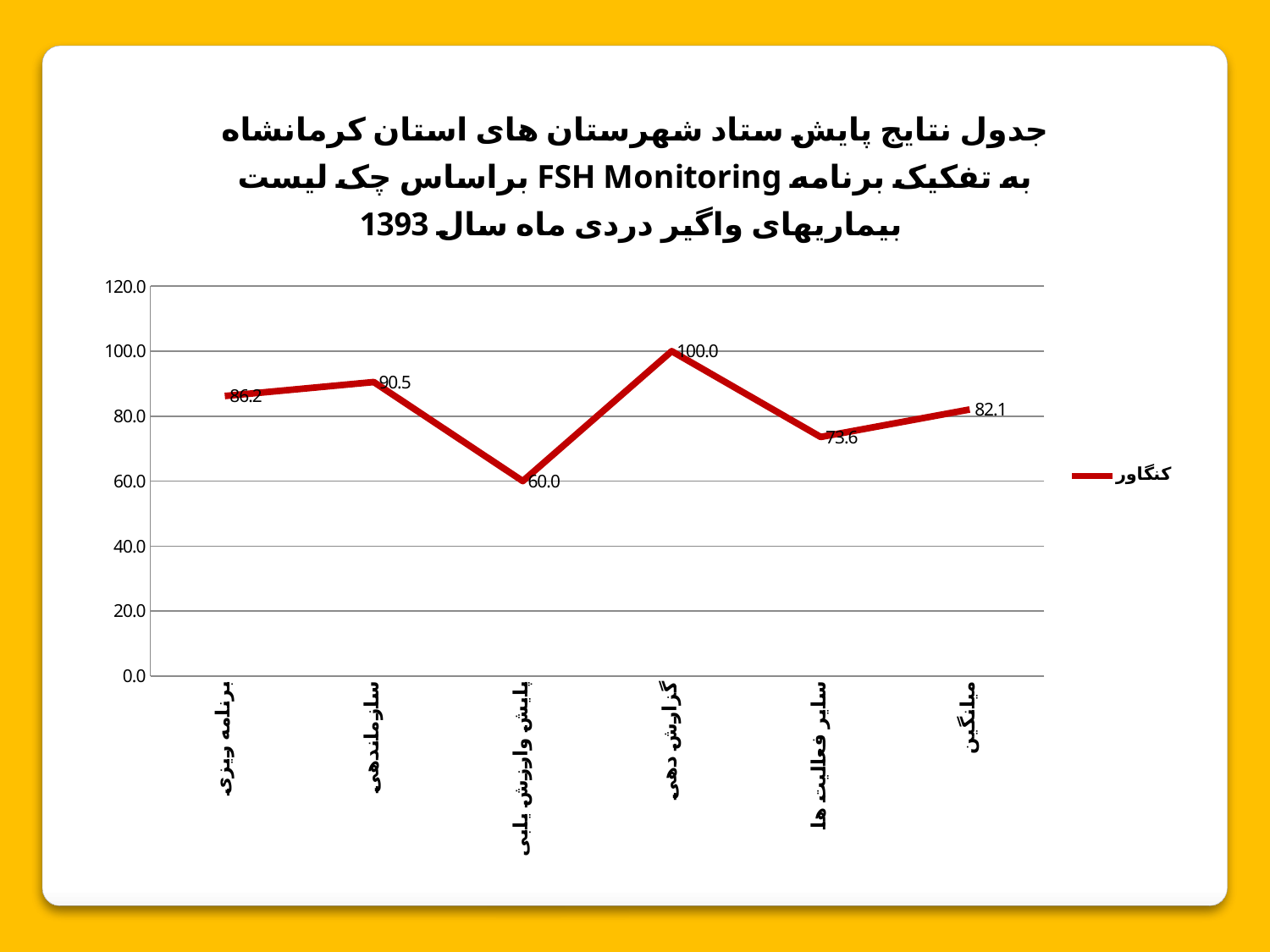
What is the value for سایر فعالیت ها? 73.6 What type of chart is shown on the slide? line chart How many series does the legend list? 1 What is the value for گزارش دهی? 100.0 Which category has the lowest value? پایش وارزش یابی How many categories are plotted on the x axis? 6 What is the value for میانگین? 82.1 What is the difference between the values for گزارش دهی and سایر فعالیت ها? 26.4 Which is larger, the value for برنامه ریزی or the value for سازماندهی? سازماندهی What is the name of the series shown in the legend? کنگاور What is the value for سازماندهی? 90.5 Which category has the highest value? گزارش دهی